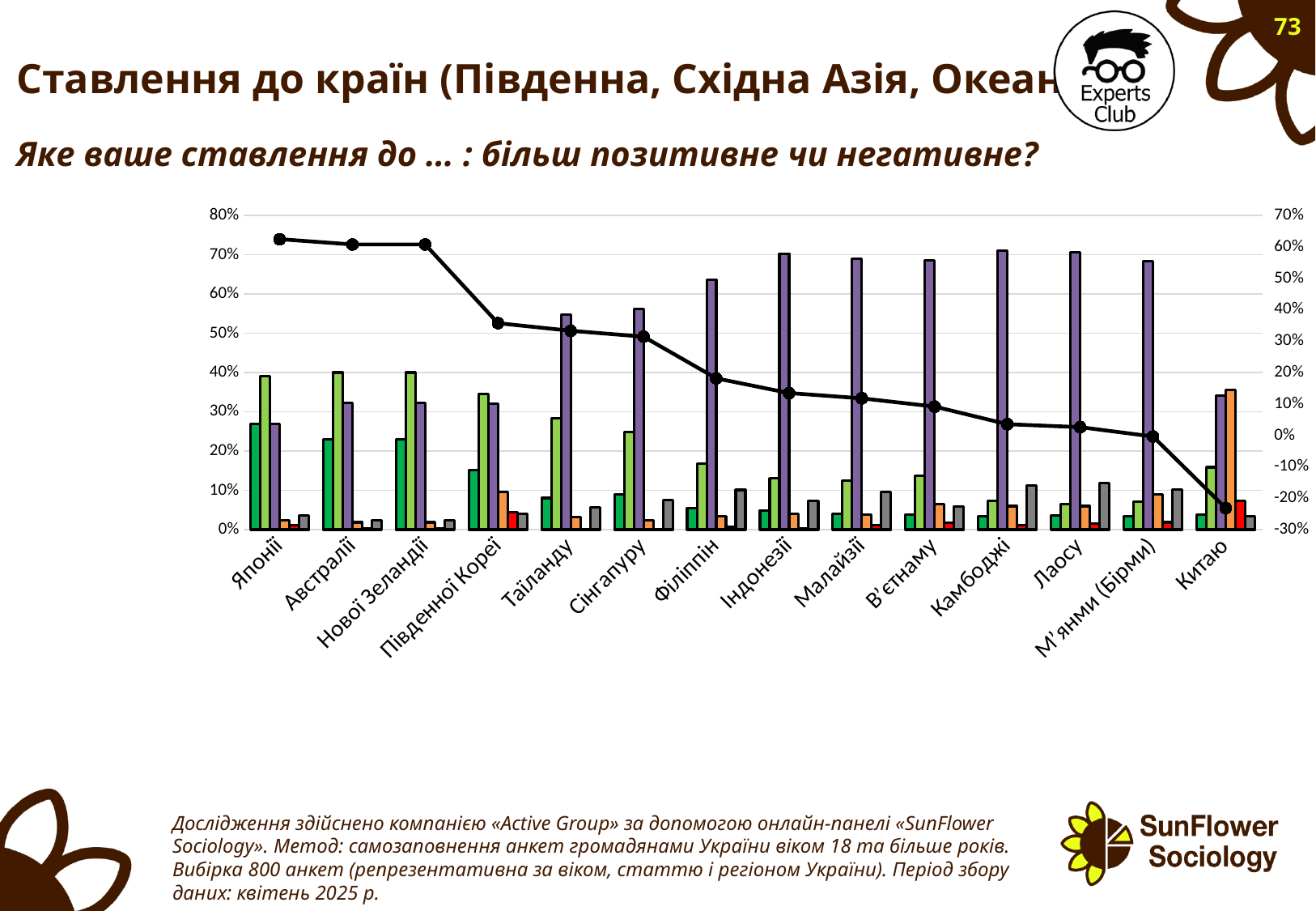
Does the black line rise or fall from left to right across the chart? It falls What kind of chart is shown on the slide? A bar chart combined with a line Is the light green bar for Австралії greater or less than 30%? greater Which is larger, the purple bar for Японії or the purple bar for Індонезії? Індонезії Is the purple bar for Південної Кореї greater or less than 40%? less Is the value of the black line for Китаю (right axis) greater or less than 0%? less Which country has the lowest value on the black line? Китаю How many countries are shown along the x axis of the chart? 14 Which is larger, the light green bar for Японії or the light green bar for Китаю? Японії Which country is listed first on the x axis of the chart? Японії